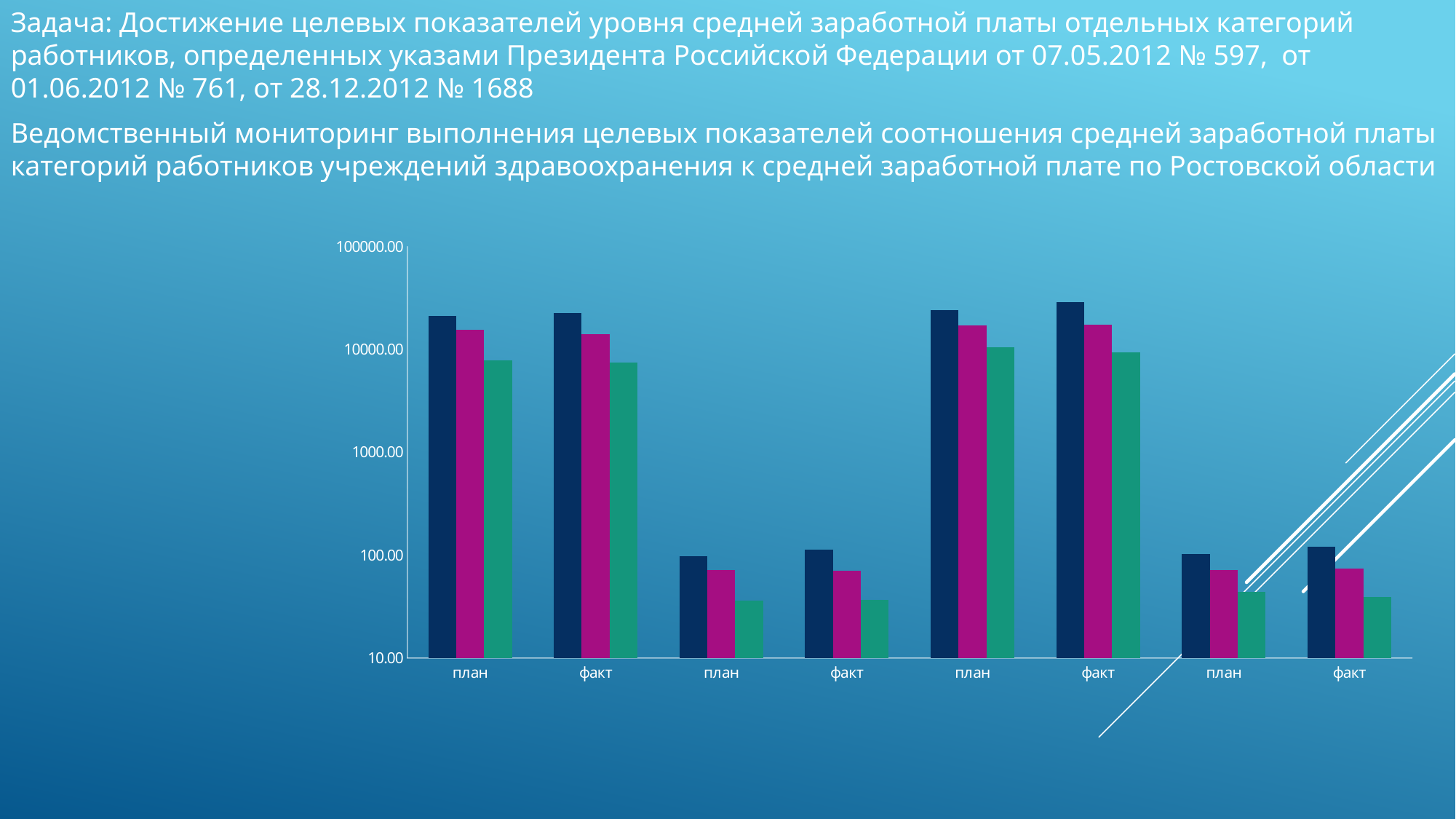
Is the value of the dark blue bar in the first "план" category greater or less than 10000.00? greater What is the lowest tick label shown on the y axis of the chart? 10.00 Is the value of the green bar in the second "план" category (third group from the left) greater or less than 100.00? less Is the value of the green bar in the fourth "план" category (seventh group from the left) greater or less than 100.00? less Among the dark blue bars, which group from the left has the highest value? the sixth group (third "факт") How many bars are plotted for each category on the chart? 3 What is the highest tick label shown on the y axis of the chart? 100000.00 In the first "план" category, which bar is taller: the dark blue bar or the green bar? the dark blue bar What kind of chart is shown on the slide? bar chart How many categories are shown along the x axis of the chart? 8